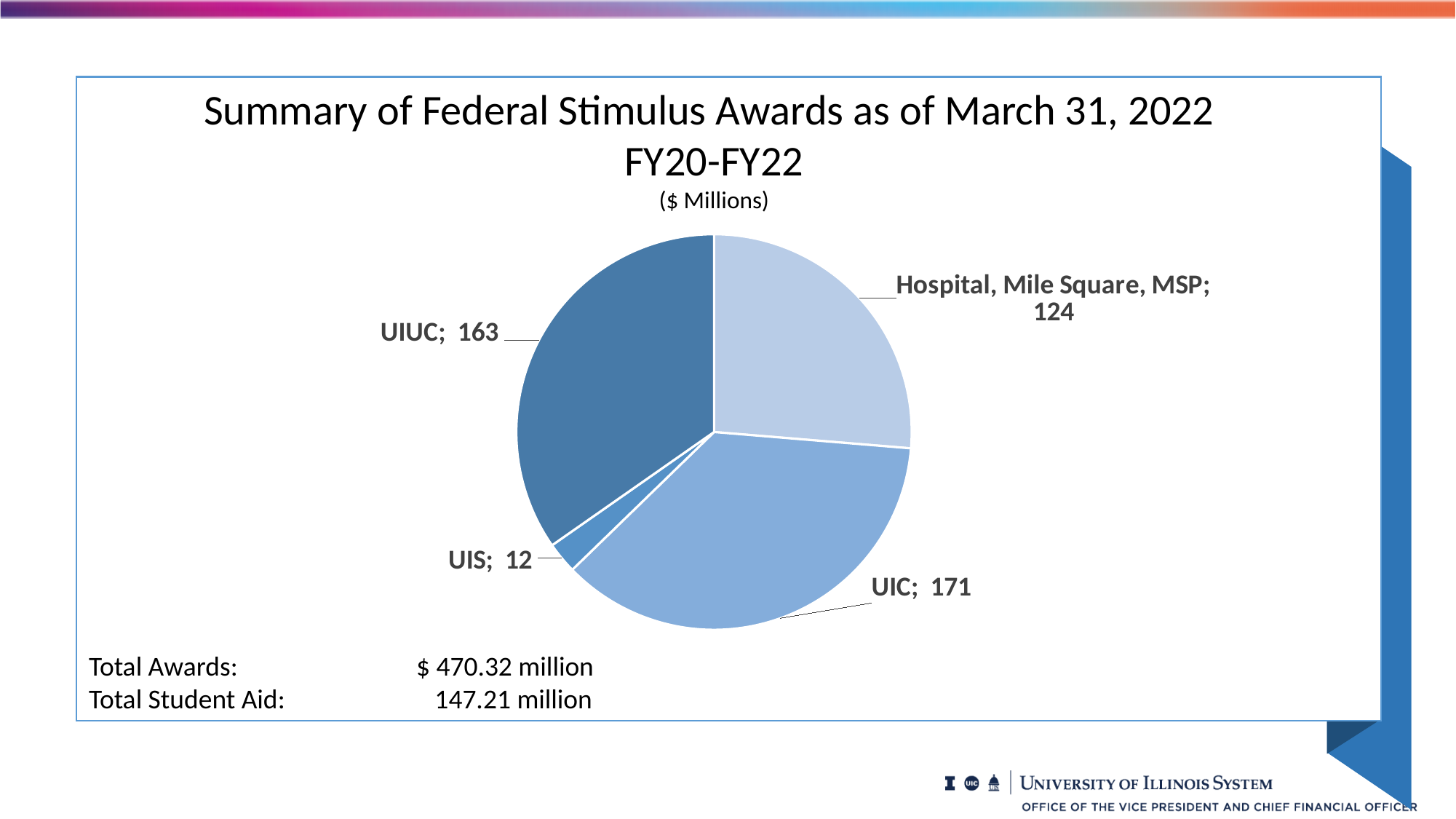
What unit is stated below the chart title? $ Millions What is the value for UIC in the pie chart? 171 Which category has the largest slice of the pie chart? UIC Which category has the smallest slice of the pie chart? UIS How many slices does the pie chart have? 4 Which is larger, the value for UIUC or the value for Hospital, Mile Square, MSP? UIUC What is the value for UIUC in the pie chart? 163 What is the difference between the values for UIUC and UIS? 151 What is the value for Hospital, Mile Square, MSP in the pie chart? 124 What is the difference between the values for UIC and UIUC? 8 What type of chart is shown on the slide? Pie chart What is the value for UIS in the pie chart? 12